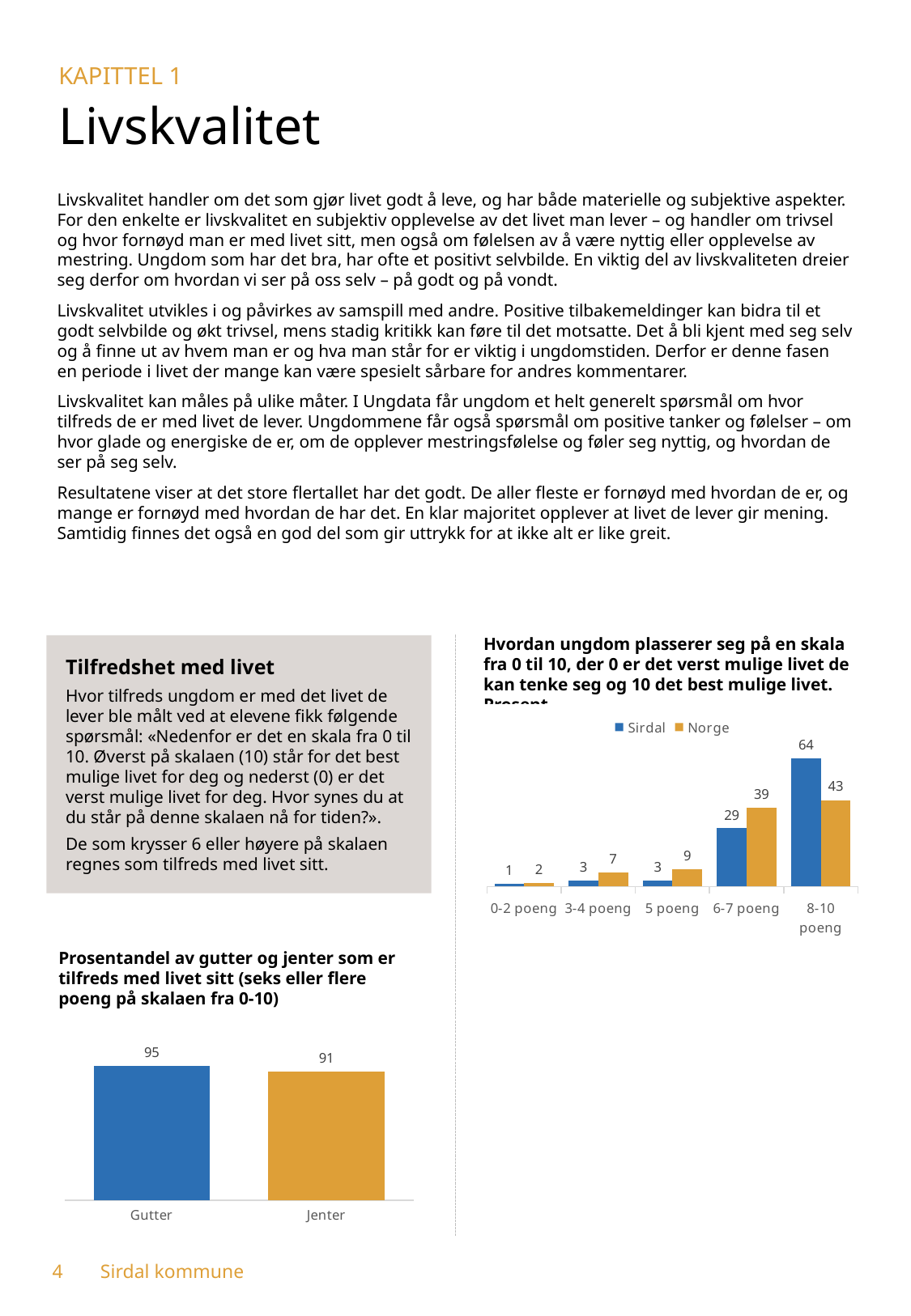
In the chart 'Prosentandel av gutter og jenter som er tilfreds med livet sitt', which category has the higher value? Gutter In the chart 'Hvordan ungdom plasserer seg på en skala fra 0 til 10', which is larger in the 5 poeng category, Sirdal or Norge? Norge In the chart 'Hvordan ungdom plasserer seg på en skala fra 0 til 10', what is the value for Norge in the 6-7 poeng category? 39 What kind of chart is 'Prosentandel av gutter og jenter som er tilfreds med livet sitt'? bar chart In the chart 'Hvordan ungdom plasserer seg på en skala fra 0 til 10', how many series does the legend list? 2 In the chart 'Hvordan ungdom plasserer seg på en skala fra 0 til 10', what is the value for Sirdal in the 8-10 poeng category? 64 In the chart 'Hvordan ungdom plasserer seg på en skala fra 0 til 10', which category has the lowest value for Sirdal? 0-2 poeng In the chart 'Hvordan ungdom plasserer seg på en skala fra 0 til 10', how many categories are shown on the x axis? 5 In the chart 'Hvordan ungdom plasserer seg på en skala fra 0 til 10', what is the difference between Sirdal and Norge in the 8-10 poeng category? 21 In the chart 'Prosentandel av gutter og jenter som er tilfreds med livet sitt', what is the value for Gutter? 95 In the chart 'Hvordan ungdom plasserer seg på en skala fra 0 til 10', which colour represents Norge? orange In the chart 'Prosentandel av gutter og jenter som er tilfreds med livet sitt', what is the difference between Gutter and Jenter? 4